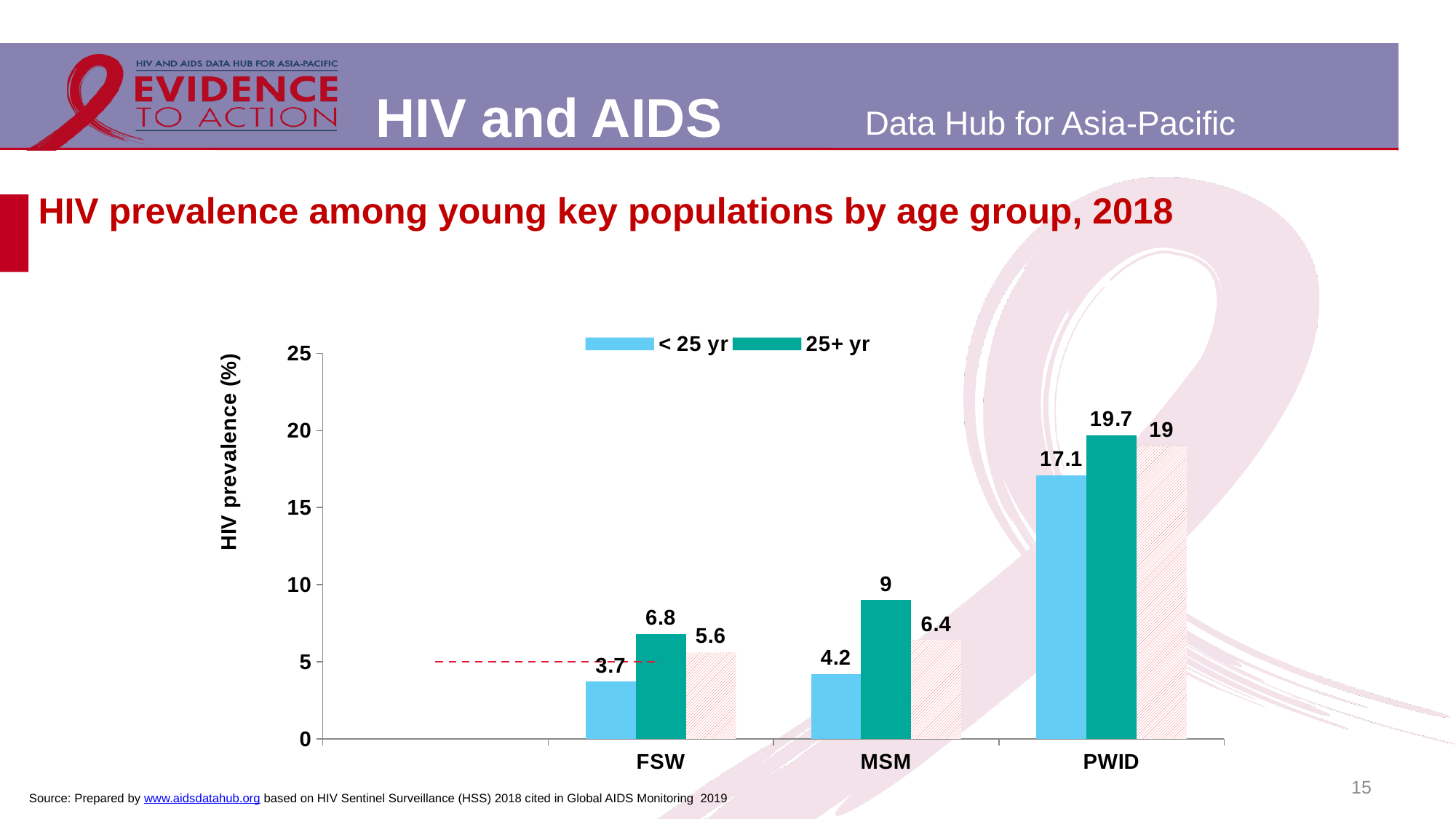
Is the HIV prevalence for the 25+ yr group among PWID greater or less than 15? greater Among FSW, which age group has the higher HIV prevalence, < 25 yr or 25+ yr? 25+ yr What is the HIV prevalence for the < 25 yr group among PWID? 17.1 How many key population categories are shown on the x axis? 3 Which key population has the highest HIV prevalence in the < 25 yr group? PWID What is the HIV prevalence for the 25+ yr group among MSM? 9 What is the HIV prevalence for the 25+ yr group among PWID? 19.7 What is the difference between the 25+ yr and < 25 yr HIV prevalence among MSM? 4.8 How many series does the legend list? 2 What is the HIV prevalence for the < 25 yr group among FSW? 3.7 Which key population has the lowest HIV prevalence in the 25+ yr group? FSW What type of chart is shown on the slide? bar chart